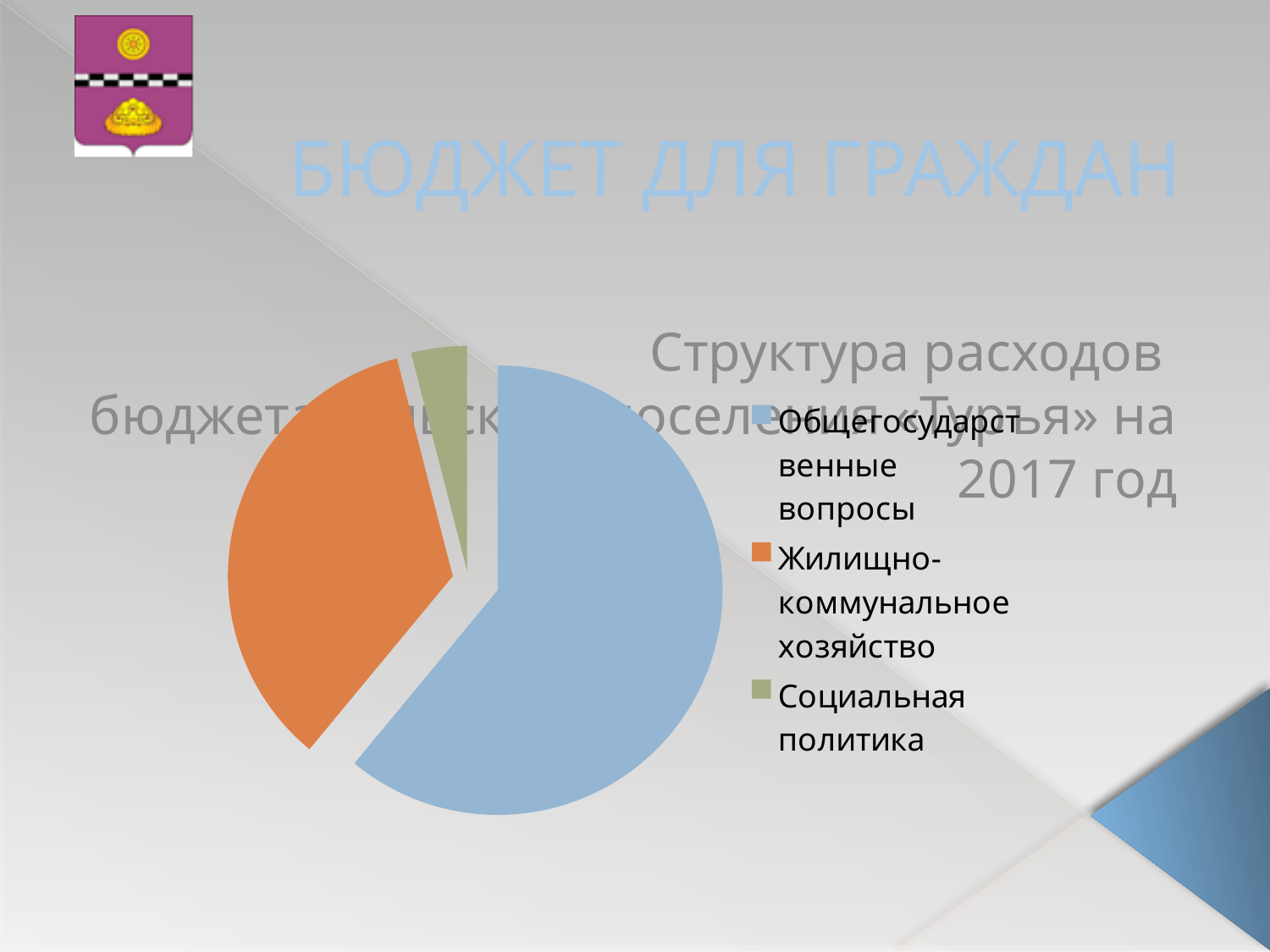
What kind of chart is shown on the slide? pie chart What colour is the slice for Жилищно-коммунальное хозяйство in the pie chart? orange Which slice is larger: Жилищно-коммунальное хозяйство or Социальная политика? Жилищно-коммунальное хозяйство Which category is shown in blue in the pie chart? Общегосударственные вопросы How many slices does the pie chart have? 3 Which category has the largest slice of the pie chart? Общегосударственные вопросы Which category has the smallest slice of the pie chart? Социальная политика Which slice is larger: Общегосударственные вопросы or Жилищно-коммунальное хозяйство? Общегосударственные вопросы How many entries does the legend of the pie chart list? 3